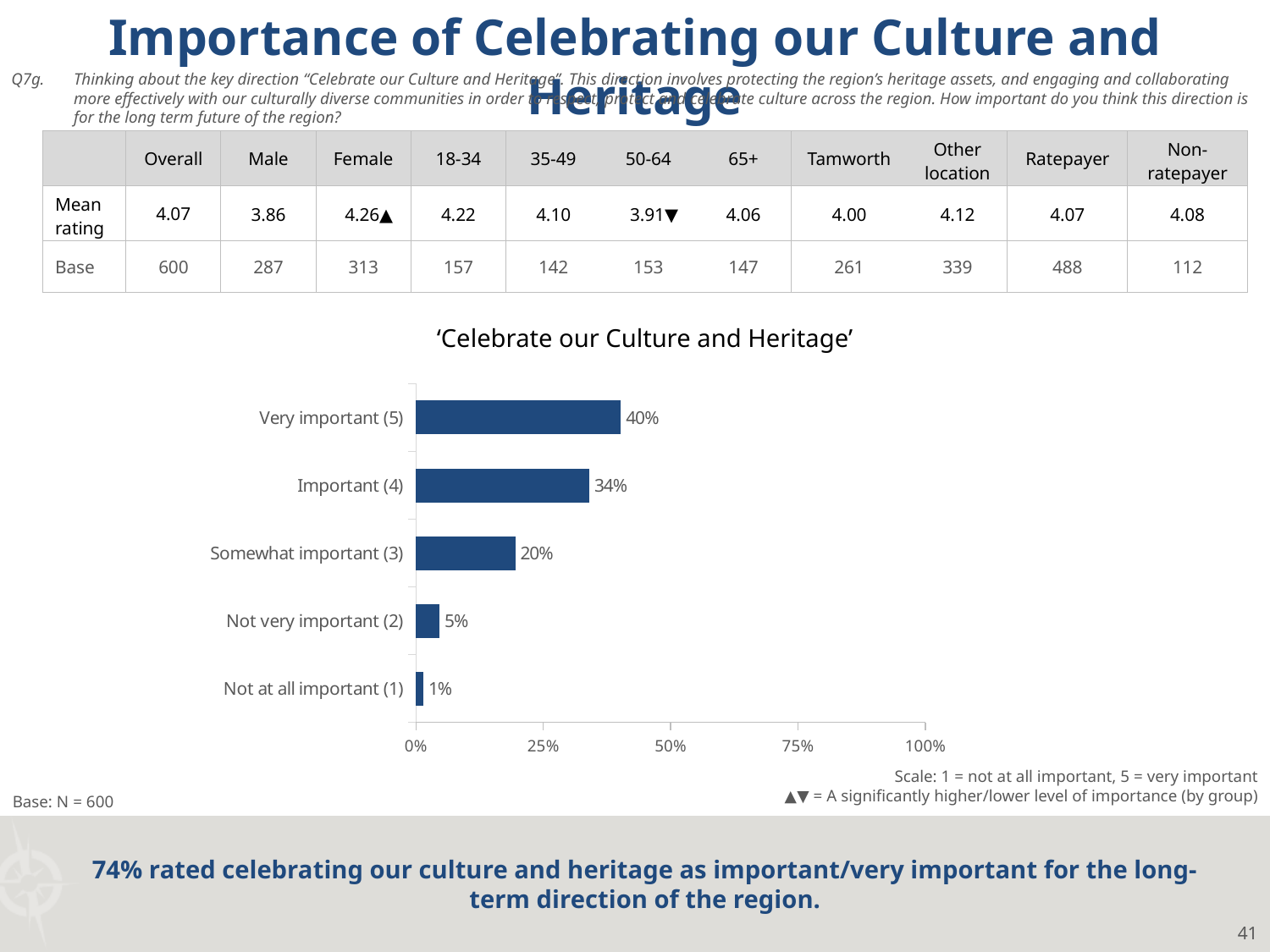
Which rating category has the lowest percentage in the chart? Not at all important (1) What percentage of respondents rated 'Celebrate our Culture and Heritage' as Very important (5)? 40% How many rating categories are shown in the chart? 5 Is the value for Very important (5) greater or less than 25%? greater What percentage of respondents rated it as Somewhat important (3)? 20% Which is larger: the percentage for Somewhat important (3) or Not very important (2)? Somewhat important (3) What percentage of respondents rated it as Important (4)? 34% What is the difference in percentage points between Very important (5) and Important (4)? 6 What percentage of respondents rated it as Not very important (2)? 5% What percentage of respondents rated it as Not at all important (1)? 1% What type of chart is used to show the importance ratings? Bar chart Which rating category has the highest percentage in the chart? Very important (5)